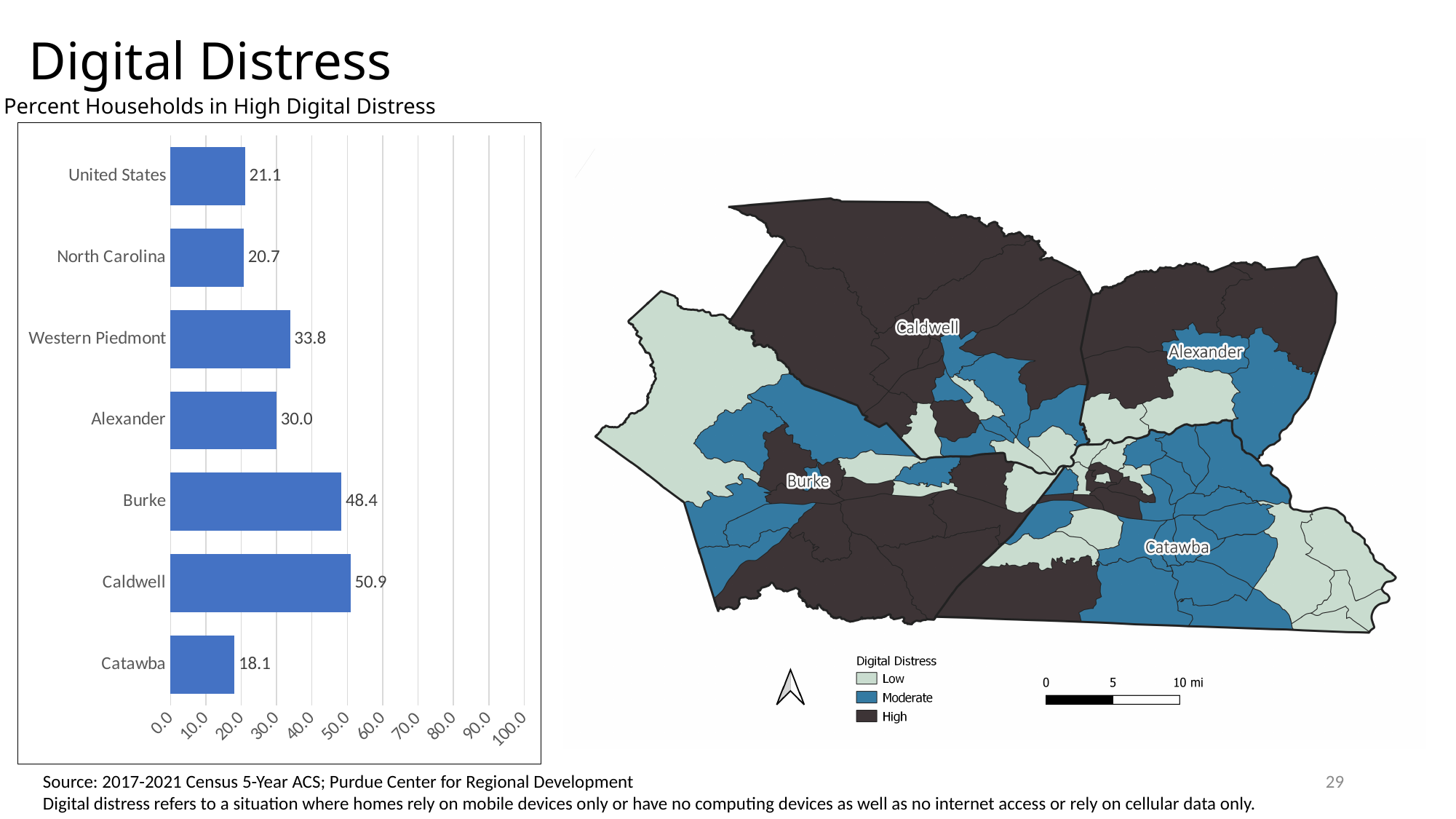
How many categories are shown in the Percent Households in High Digital Distress chart? 7 Is the value for Western Piedmont in the Percent Households in High Digital Distress chart greater or less than 30.0? greater What is the value for Western Piedmont in the Percent Households in High Digital Distress chart? 33.8 What is the difference between the values for Alexander and North Carolina in the Percent Households in High Digital Distress chart? 9.3 Which category has the lowest value in the Percent Households in High Digital Distress chart? Catawba What is the value for Burke in the Percent Households in High Digital Distress chart? 48.4 Which is larger in the Percent Households in High Digital Distress chart, the value for Burke or the value for Alexander? Burke What is the value for the United States in the Percent Households in High Digital Distress chart? 21.1 What kind of chart is the Percent Households in High Digital Distress chart? bar chart What is the difference between the values for Caldwell and Catawba in the Percent Households in High Digital Distress chart? 32.8 What is the value for Caldwell in the Percent Households in High Digital Distress chart? 50.9 Which category has the highest value in the Percent Households in High Digital Distress chart? Caldwell